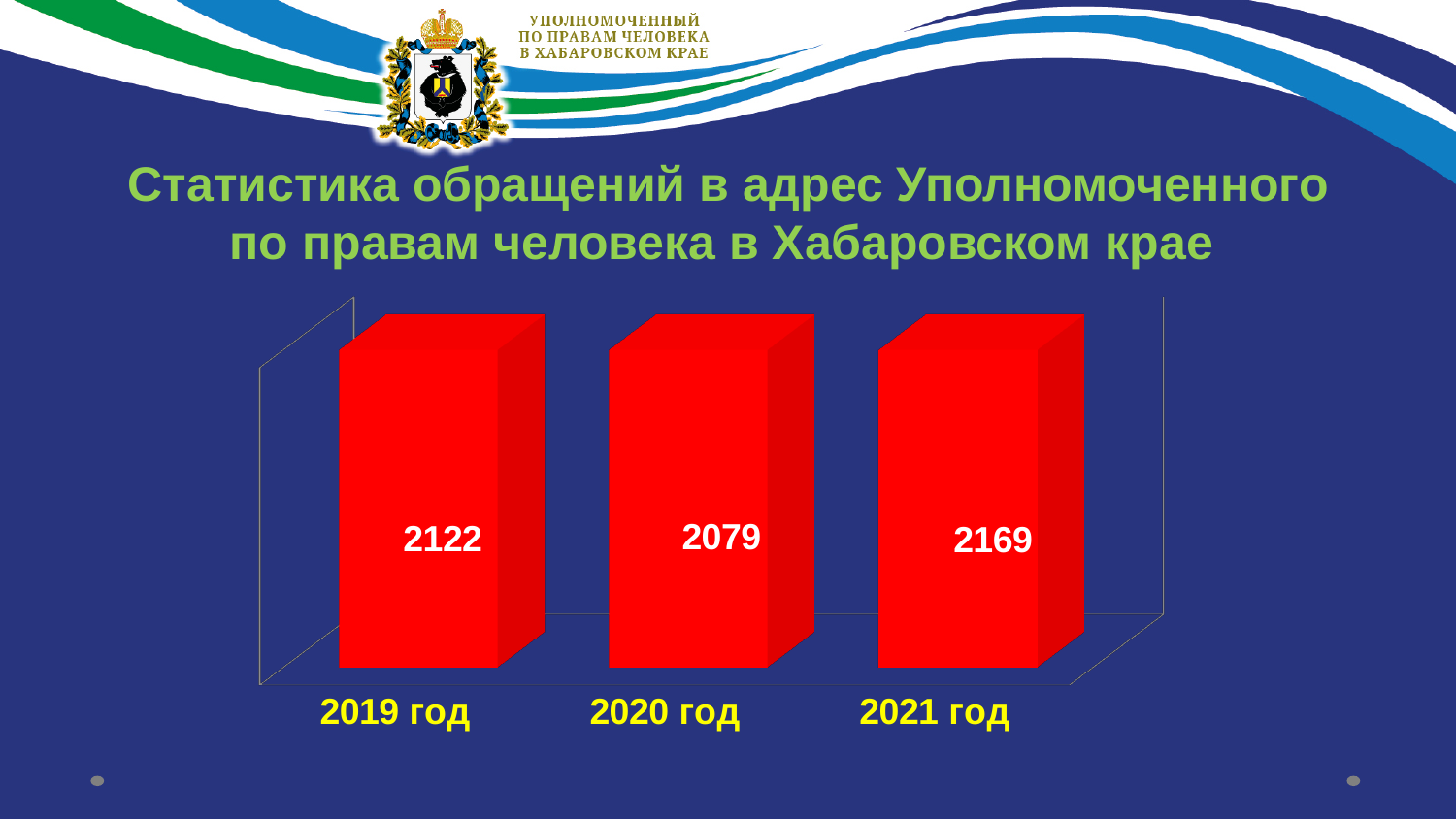
What is the value for 2020 год? 2079 What colour are the bars in the chart? Red Which year has the lowest value? 2020 год What is the value for 2019 год? 2122 How many bars are shown in the chart? 3 What is the difference between the values for 2019 год and 2020 год? 43 Does the value rise or fall from 2020 год to 2021 год? Rise Which year has the highest value? 2021 год Which is larger, the value for 2019 год or the value for 2021 год? 2021 год What kind of chart is shown on the slide? Bar chart What is the value for 2021 год? 2169 What is the difference between the values for 2021 год and 2020 год? 90